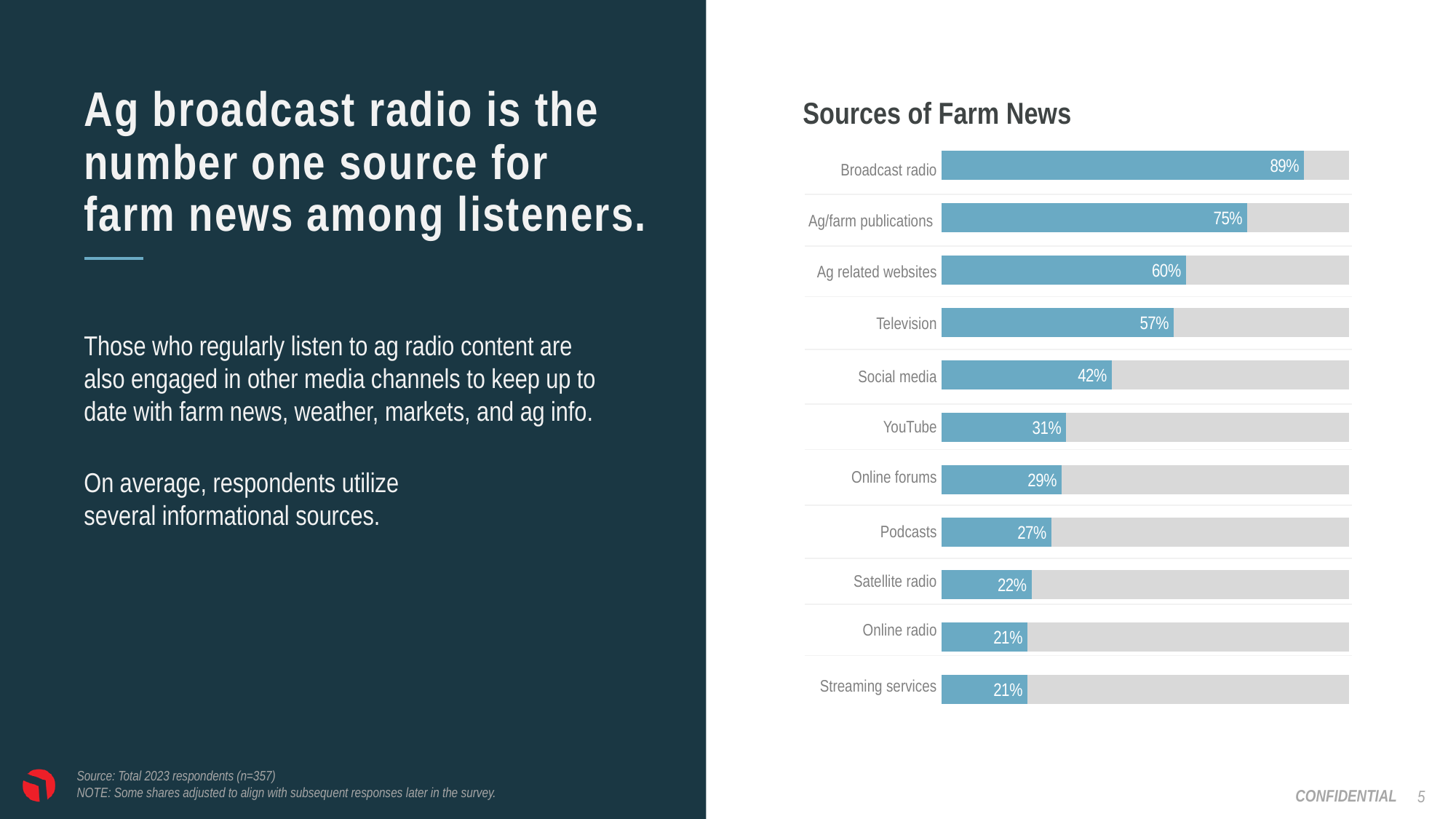
What is the value for Satellite radio? 22% What kind of chart is shown? Bar chart How many sources are shown in the chart? 11 Which is larger, Podcasts or Online forums? Online forums What is the value for Television? 57% What is the difference between Social media and YouTube? 11% What is the value for Broadcast radio? 89% Do the values rise or fall from the top bar to the bottom bar? Fall What is the title of the chart? Sources of Farm News What is the difference between Broadcast radio and Ag/farm publications? 14% Which is larger, Ag related websites or Television? Ag related websites Which source has the highest value? Broadcast radio